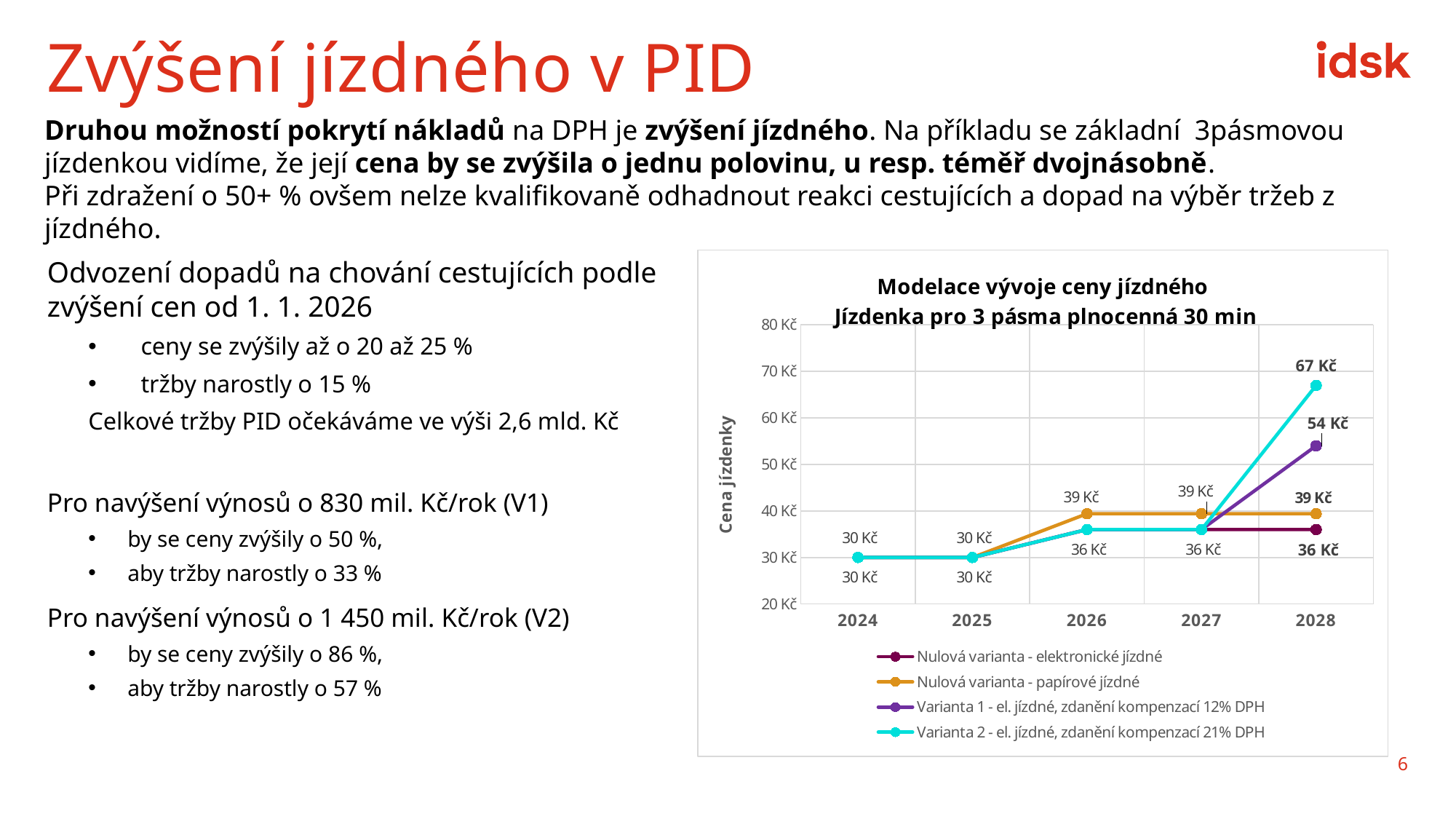
What is the difference between the 2028 values of Varianta 2 and Varianta 1? 13 Kč Does the value of the series 'Varianta 2 - el. jízdné, zdanění kompenzací 21% DPH' rise or fall from 2024 to 2028? rise What is the value of the series 'Varianta 2 - el. jízdné, zdanění kompenzací 21% DPH' in 2028? 67 Kč Which series has the highest value in 2028? Varianta 2 - el. jízdné, zdanění kompenzací 21% DPH What is the title of the chart? Modelace vývoje ceny jízdného Jízdenka pro 3 pásma plnocenná 30 min Which series has the lowest value in 2028? Nulová varianta - elektronické jízdné How many years are shown on the x axis of the chart? 5 What type of chart is shown on the slide? line chart What is the value of the series 'Varianta 1 - el. jízdné, zdanění kompenzací 12% DPH' in 2028? 54 Kč How many series does the legend of the chart list? 4 What is the value of the series 'Nulová varianta - elektronické jízdné' in 2028? 36 Kč What is the value of the series 'Nulová varianta - papírové jízdné' in 2026? 39 Kč